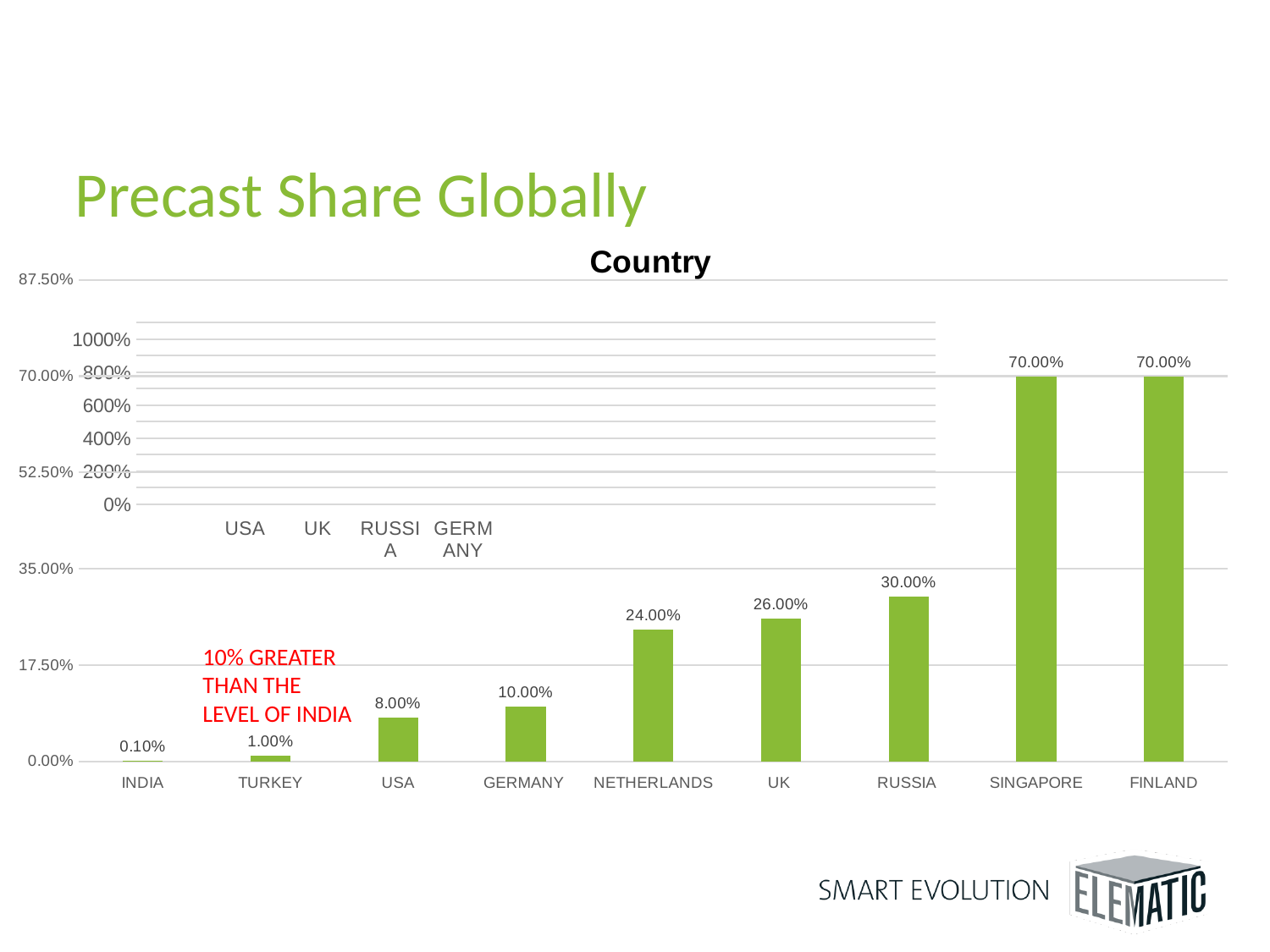
In the 'Country' chart, do the values generally rise or fall from left to right? rise In the 'Country' chart, what is the value for India? 0.10% In the 'Country' chart, which is larger, the value for UK or the value for Netherlands? UK In the 'Country' chart, is the value for Germany greater or less than 17.50%? less In the 'Country' chart, what is the value for Netherlands? 24.00% In the 'Country' chart, which countries share the highest value? Singapore and Finland What kind of chart is the 'Country' chart? bar chart In the 'Country' chart, what is the difference between the values for Russia and UK? 4.00% In the 'Country' chart, which country has the lowest value? India How many countries are shown in the 'Country' chart? 9 In the 'Country' chart, what is the difference between the values for Finland and Russia? 40.00% In the 'Country' chart, what is the value for Russia? 30.00%